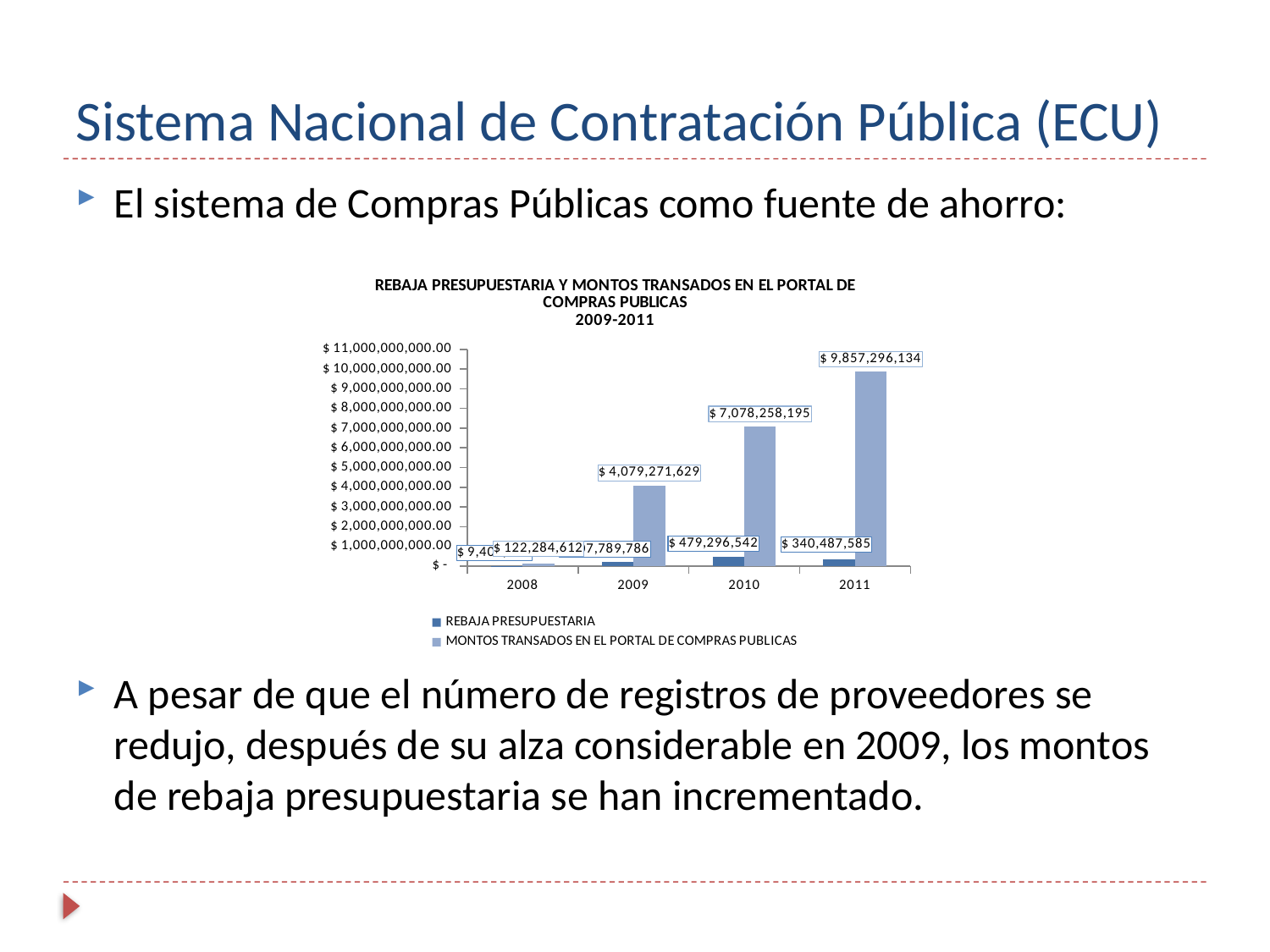
What is the value of MONTOS TRANSADOS EN EL PORTAL DE COMPRAS PUBLICAS for 2009? $ 4,079,271,629 In which year is MONTOS TRANSADOS EN EL PORTAL DE COMPRAS PUBLICAS highest? 2011 Do the values of MONTOS TRANSADOS EN EL PORTAL DE COMPRAS PUBLICAS rise or fall from 2008 to 2011? Rise What type of chart is shown on the slide? Bar chart What is the value of MONTOS TRANSADOS EN EL PORTAL DE COMPRAS PUBLICAS for 2011? $ 9,857,296,134 How many series does the legend list? 2 How many years are shown on the x axis of the chart? 4 What is the value of REBAJA PRESUPUESTARIA for 2011? $ 340,487,585 Which is larger, REBAJA PRESUPUESTARIA in 2010 or in 2011? 2010 What is the value of REBAJA PRESUPUESTARIA for 2010? $ 479,296,542 In which year is MONTOS TRANSADOS EN EL PORTAL DE COMPRAS PUBLICAS lowest? 2008 What is the difference between MONTOS TRANSADOS EN EL PORTAL DE COMPRAS PUBLICAS in 2011 and in 2010? $ 2,779,037,939